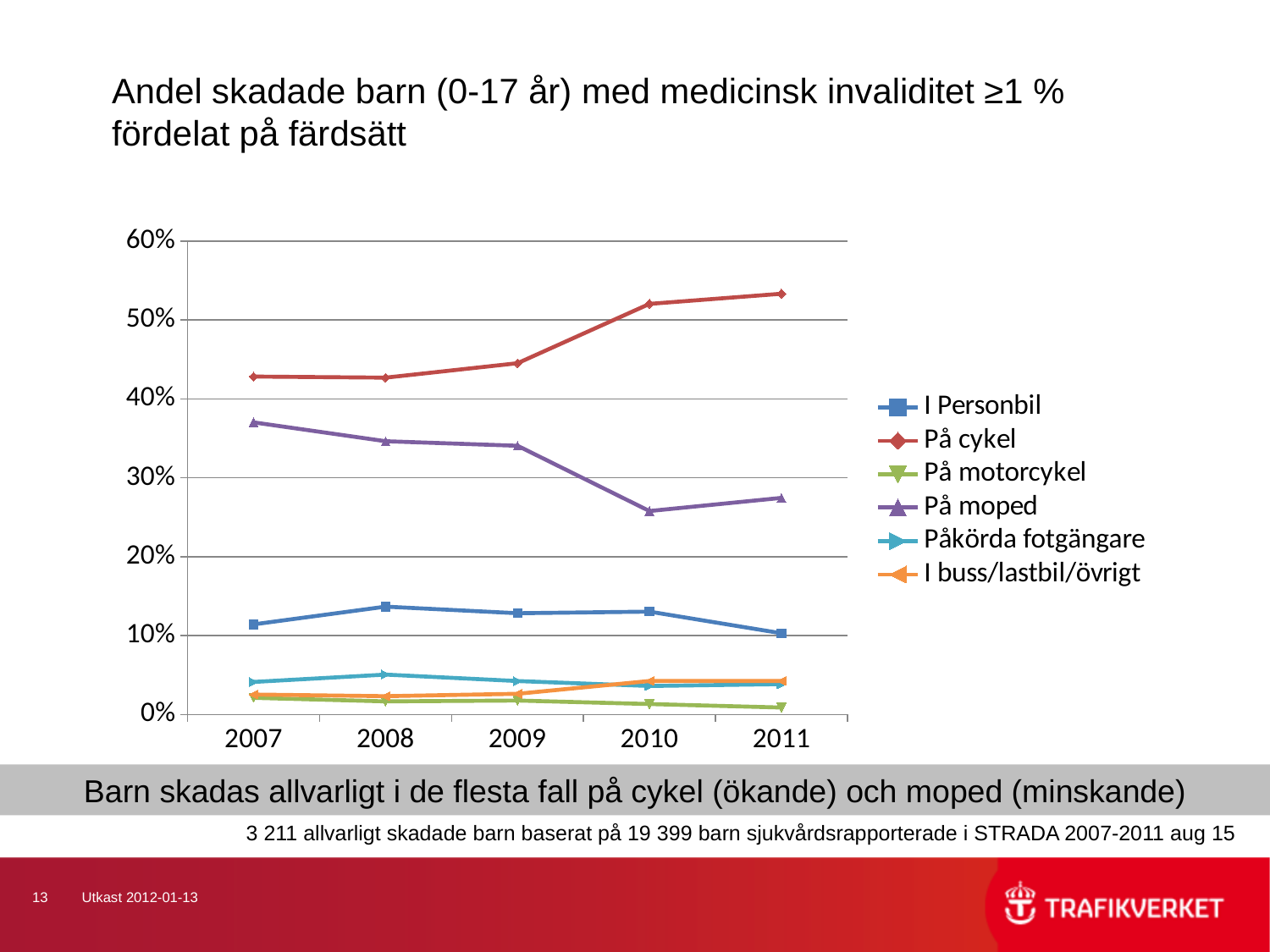
How many series does the legend list? 6 Is the value for På cykel in 2011 greater or less than 50%? greater Which series is shown with a red line and diamond markers? På cykel How many years are shown on the x axis? 5 In 2010, which is larger: the value for På cykel or the value for På moped? På cykel Does the value for På moped rise or fall from 2007 to 2010? fall Which series has the lowest value in 2011? På motorcykel Does the value for På cykel rise or fall from 2007 to 2011? rise Which series has the highest value in 2011? På cykel Is the value for På moped in 2010 greater or less than 30%? less What kind of chart is shown on the slide? line chart Is the value for I Personbil in 2008 greater or less than 10%? greater